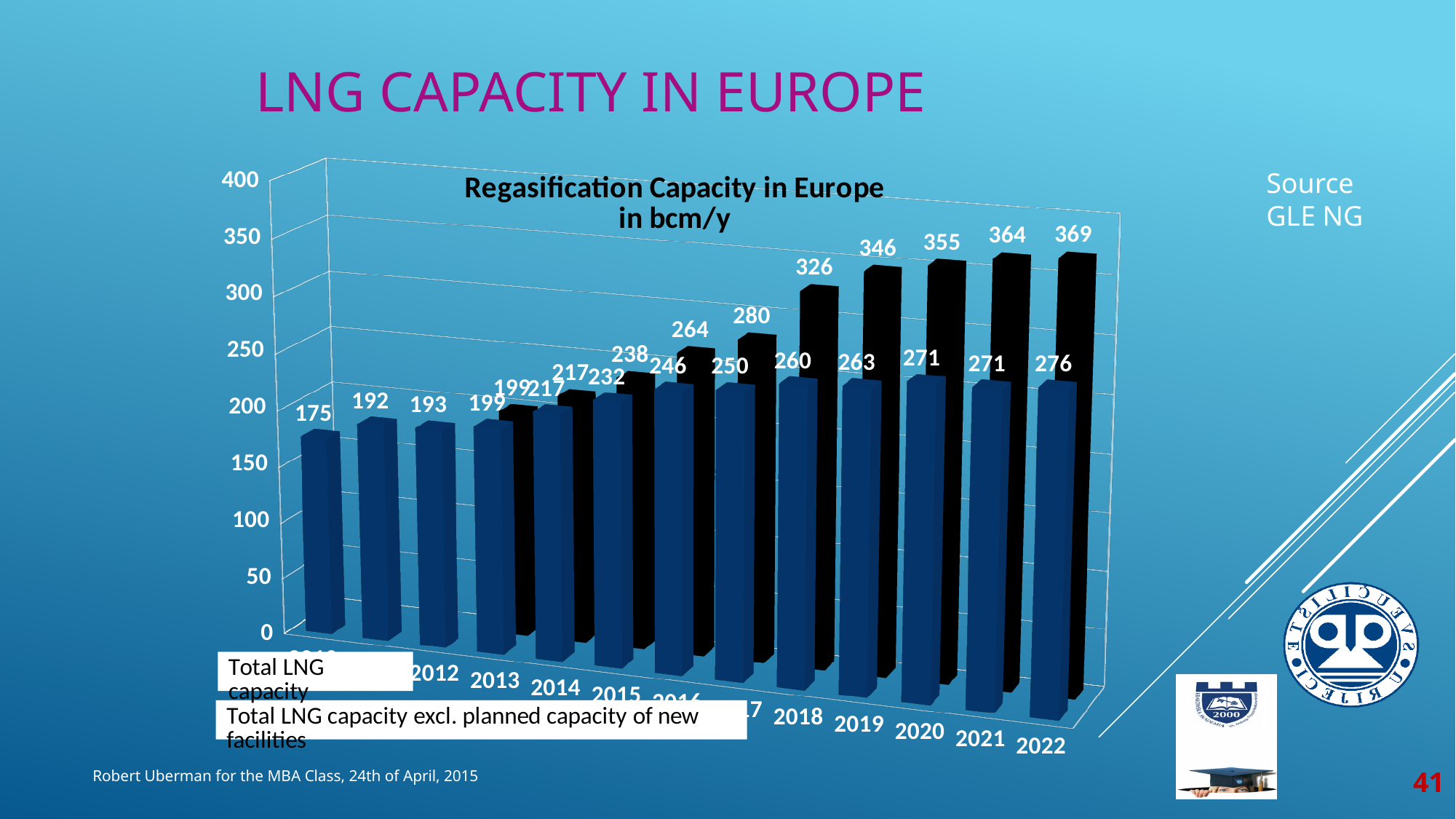
What is the value of the blue bar for 2022? 276 What is the value of the black bar for 2022? 369 What is the value of the blue bar for 2012? 193 What is the difference between the black bar and the blue bar for 2022? 93 What kind of chart is shown on the slide? bar chart Do the blue bars generally rise or fall from 2012 to 2022? rise Is the value of the blue bar for 2022 greater or less than 300? less For 2020, which is larger: the black bar or the blue bar? the black bar In which year is the black bar highest? 2022 By how much does the black bar increase from 2018 to 2019? 20 What is the value of the black bar for 2018? 326 In which year is the blue bar highest? 2022